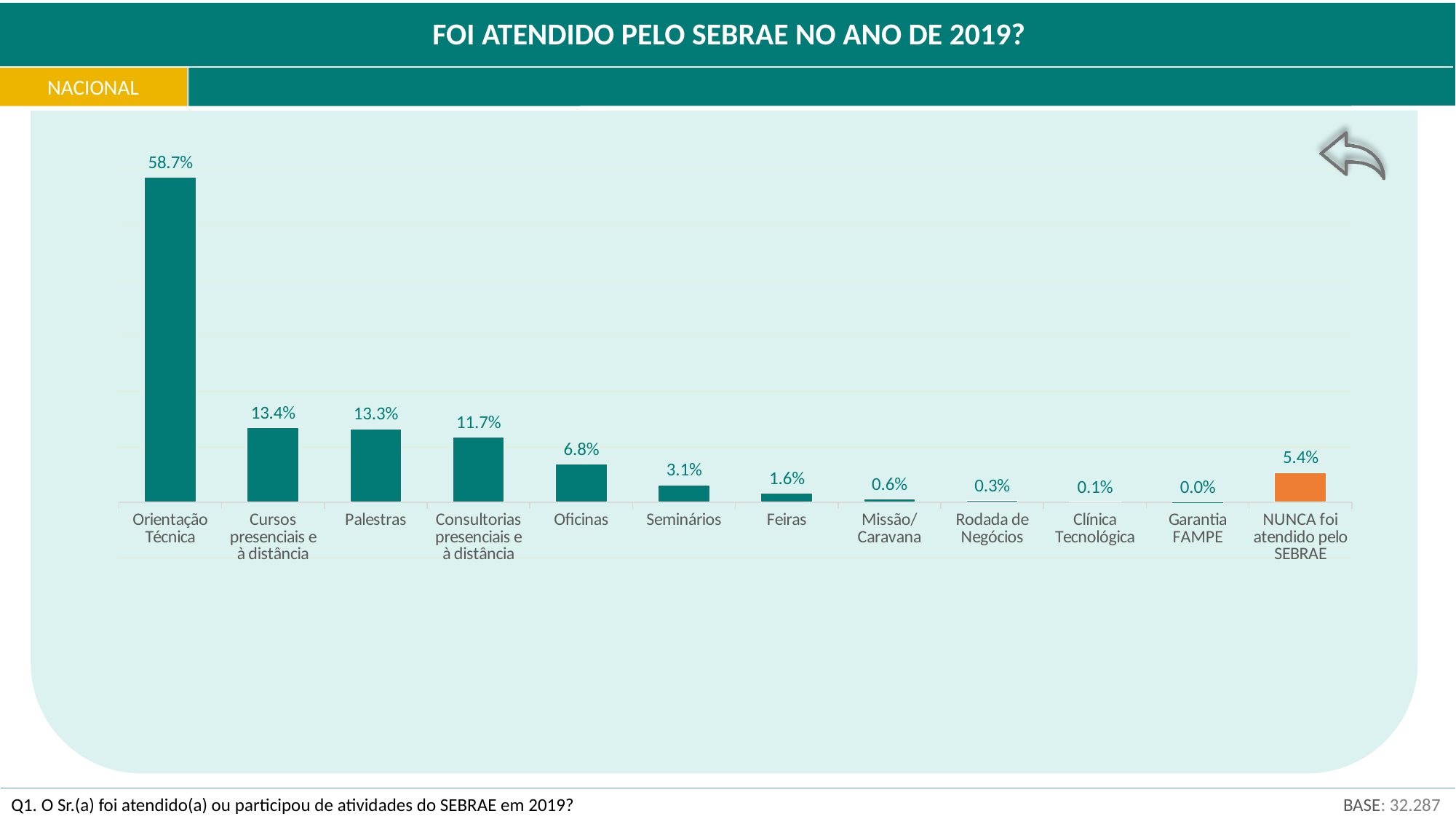
What is the difference between Oficinas and NUNCA foi atendido pelo SEBRAE? 1.4% What is the value for Orientação Técnica? 58.7% Which bar is shown in orange rather than teal? NUNCA foi atendido pelo SEBRAE What is the value for Oficinas? 6.8% What is the value for NUNCA foi atendido pelo SEBRAE? 5.4% What kind of chart is shown on the slide? Bar chart How many categories are shown in the chart? 12 Which category has the lowest value? Garantia FAMPE What is the value for Seminários? 3.1% Which is larger, Consultorias presenciais e à distância or Oficinas? Consultorias presenciais e à distância Which category has the highest value? Orientação Técnica What is the difference between Orientação Técnica and Cursos presenciais e à distância? 45.3%